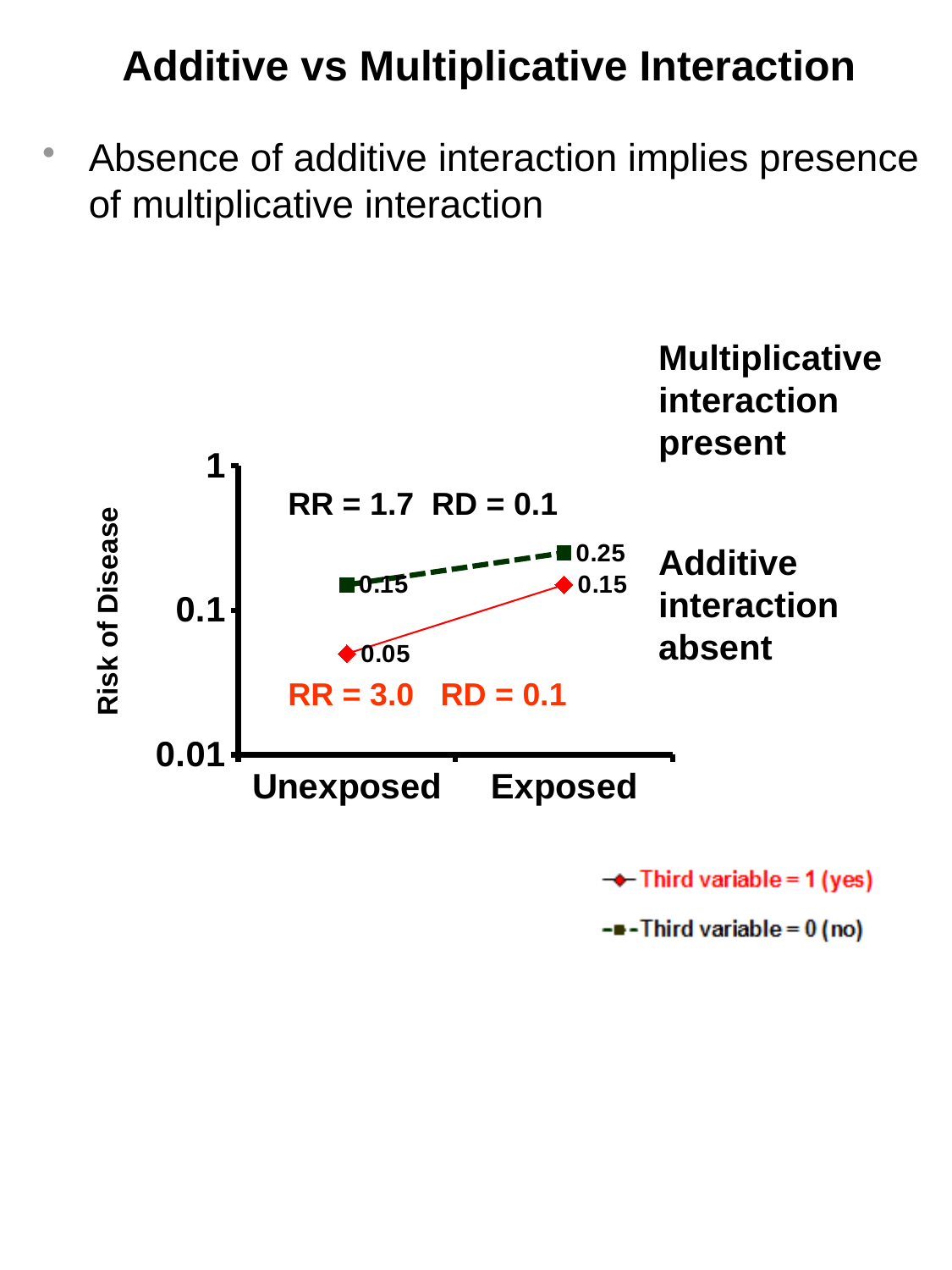
How many series does the legend list? 2 Which point has the lowest risk of disease on the chart? Unexposed, Third variable = 1 (yes) Does the risk of disease rise or fall from Unexposed to Exposed for the Third variable = 1 (yes) series? Rise Which series has the higher risk of disease for the Unexposed group? Third variable = 0 (no) What is the risk of disease for the Unexposed group when Third variable = 1 (yes)? 0.05 What is the risk of disease for the Exposed group when Third variable = 1 (yes)? 0.15 Is the risk of disease for the Exposed group with Third variable = 0 (no) greater or less than 0.1? greater What kind of chart is shown on the slide? Line chart What is the difference in risk of disease between Exposed and Unexposed for the Third variable = 0 (no) series? 0.1 What is the risk of disease for the Unexposed group when Third variable = 0 (no)? 0.15 What is the risk of disease for the Exposed group when Third variable = 0 (no)? 0.25 What is the difference in risk of disease between Exposed and Unexposed for the Third variable = 1 (yes) series? 0.1